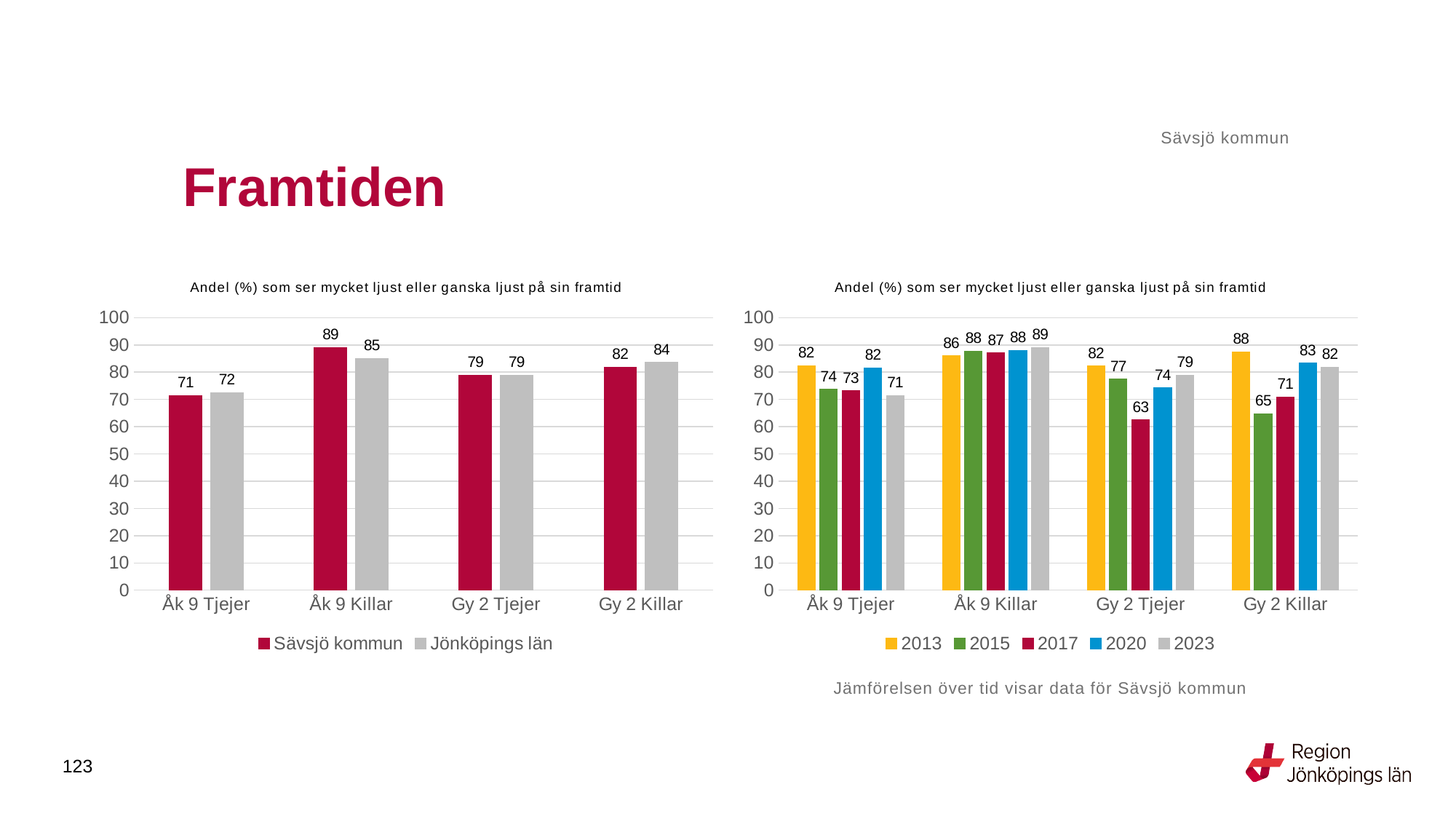
In the left chart, what is the difference between Sävsjö kommun and Jönköpings län for Åk 9 Killar? 4 In the right chart, is the value for 2013 or 2023 larger for Åk 9 Tjejer? 2013 In the right chart, which year has the lowest value for Gy 2 Killar? 2015 In the left chart, which category has the highest value for Sävsjö kommun? Åk 9 Killar In the right chart, how many series does the legend list? 5 In the left chart, what is the value for Jönköpings län for Gy 2 Killar? 84 In the left chart, which category has the lowest value for Jönköpings län? Åk 9 Tjejer In the right chart, what is the value for 2017 for Gy 2 Tjejer? 63 In the left chart, how many series does the legend list? 2 What kind of chart is the right chart? Bar chart In the left chart, what is the value for Sävsjö kommun for Åk 9 Killar? 89 In the right chart, what is the value for 2023 for Åk 9 Killar? 89